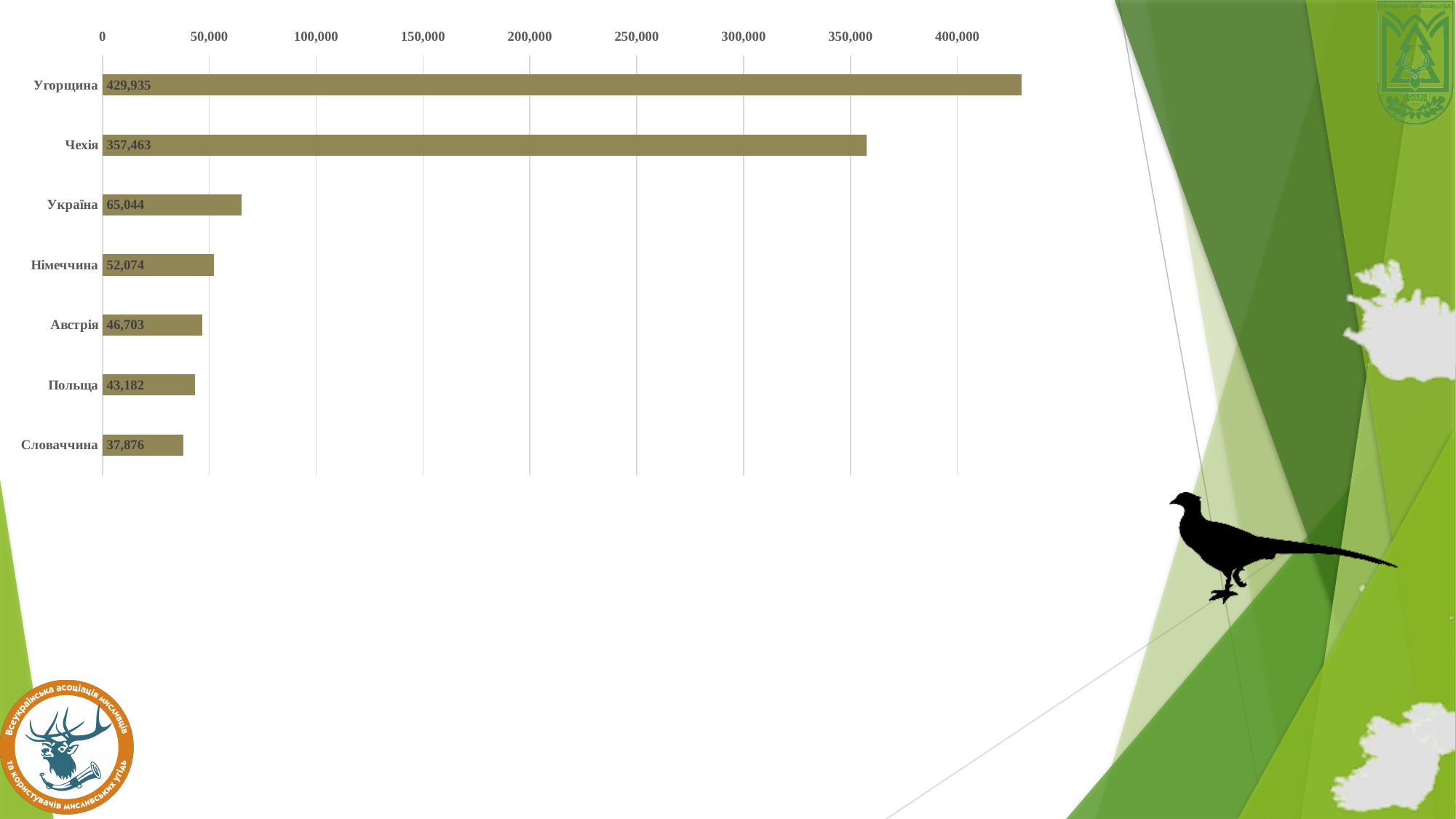
What is the value shown for Угорщина? 429,935 What is the difference between the values for Україна and Німеччина? 12,970 What is the value shown for Україна? 65,044 What is the value shown for Словаччина? 37,876 Which category has the highest value? Угорщина What is the difference between the values for Угорщина and Чехія? 72,472 Is the value for Чехія greater or less than 300,000? greater How many categories are shown in the chart? 7 Which category has the lowest value? Словаччина What is the value shown for Чехія? 357,463 Which has a larger value, Австрія or Польща? Австрія What kind of chart is shown on the slide? Bar chart